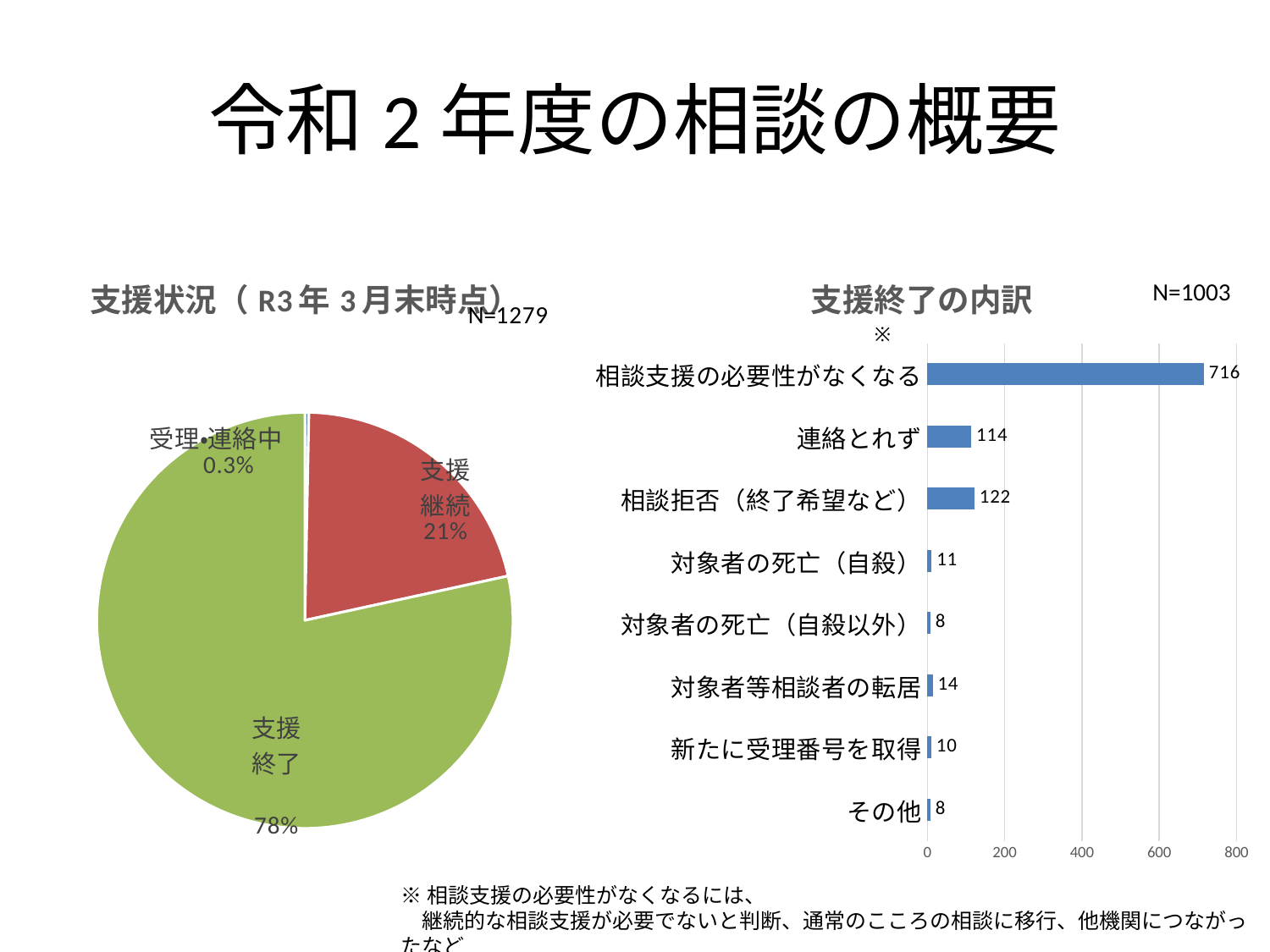
In the 支援終了の内訳 chart, what is the difference between 相談拒否（終了希望など） and 連絡とれず? 8 In the 支援終了の内訳 chart, how many categories are shown? 8 In the 支援状況（R3年3月末時点） pie chart, what share does 支援終了 have? 78% In the 支援終了の内訳 chart, what is the value for 連絡とれず? 114 In the 支援状況（R3年3月末時点） pie chart, which slice is the largest? 支援終了 In the 支援終了の内訳 chart, which category has the highest value? 相談支援の必要性がなくなる In the 支援状況（R3年3月末時点） pie chart, what share does 受理・連絡中 have? 0.3% In the 支援終了の内訳 chart, what is the value for 対象者等相談者の転居? 14 What is the N value shown for the 支援終了の内訳 chart? N=1003 In the 支援終了の内訳 chart, which is larger, 対象者の死亡（自殺） or 新たに受理番号を取得? 対象者の死亡（自殺） In the 支援終了の内訳 chart, what is the value for 相談支援の必要性がなくなる? 716 What kind of chart is the 支援終了の内訳 chart? bar chart